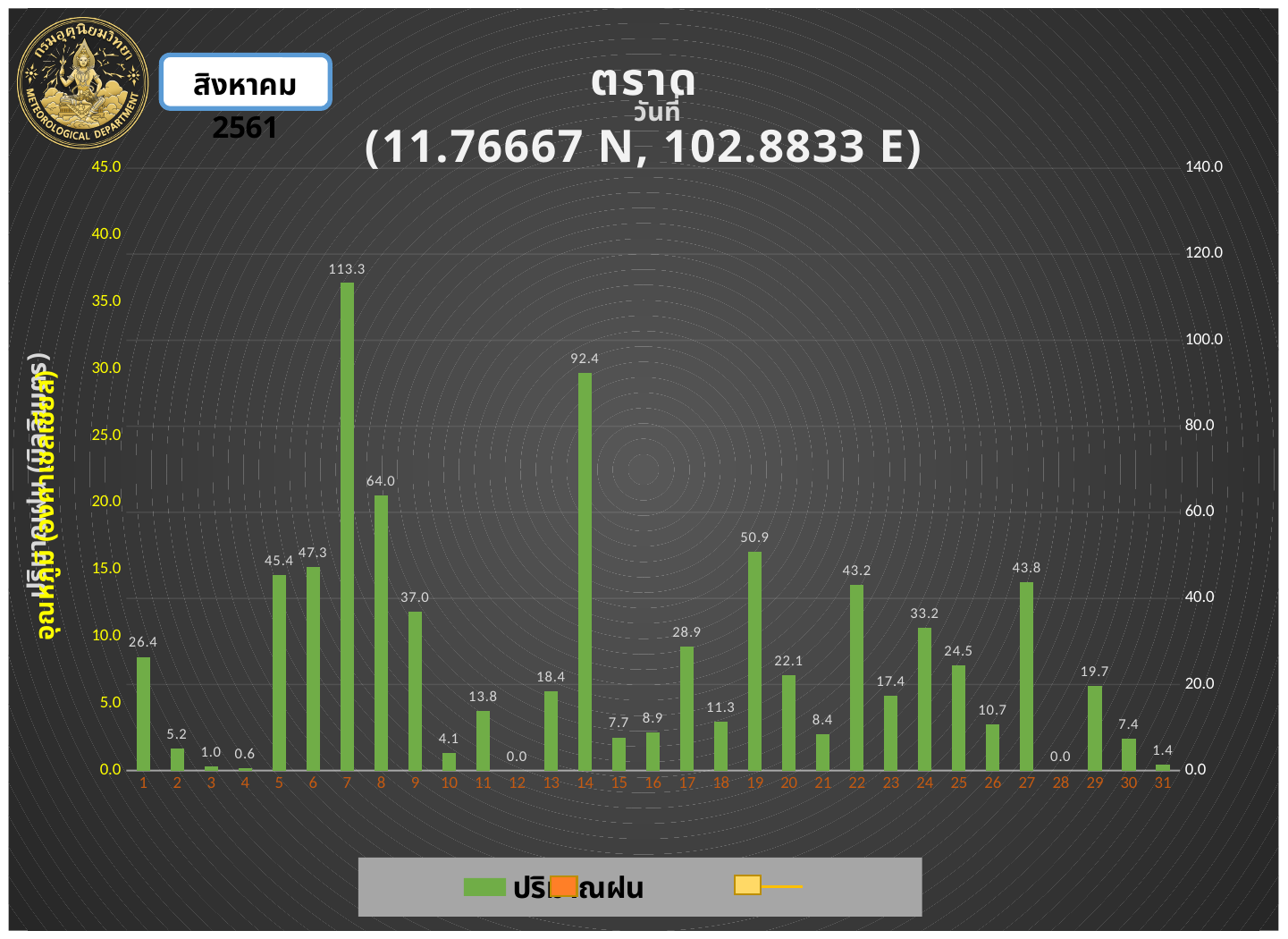
What is the difference between the rainfall values for day 8 and day 9? 27.0 What is the rainfall value for day 19? 50.9 Which has the larger rainfall value, day 22 or day 24? day 22 What kind of chart is shown on the slide? bar chart What is the difference between the rainfall values for day 7 and day 14? 20.9 Do the rainfall values rise or fall from day 5 to day 7? rise What is the lowest rainfall value shown on the chart? 0.0 What is the rainfall value for day 7? 113.3 What is the rainfall value for day 14? 92.4 Which day has the highest rainfall value? 7 How many days are shown on the x axis of the chart? 31 Which has the larger rainfall value, day 5 or day 6? day 6